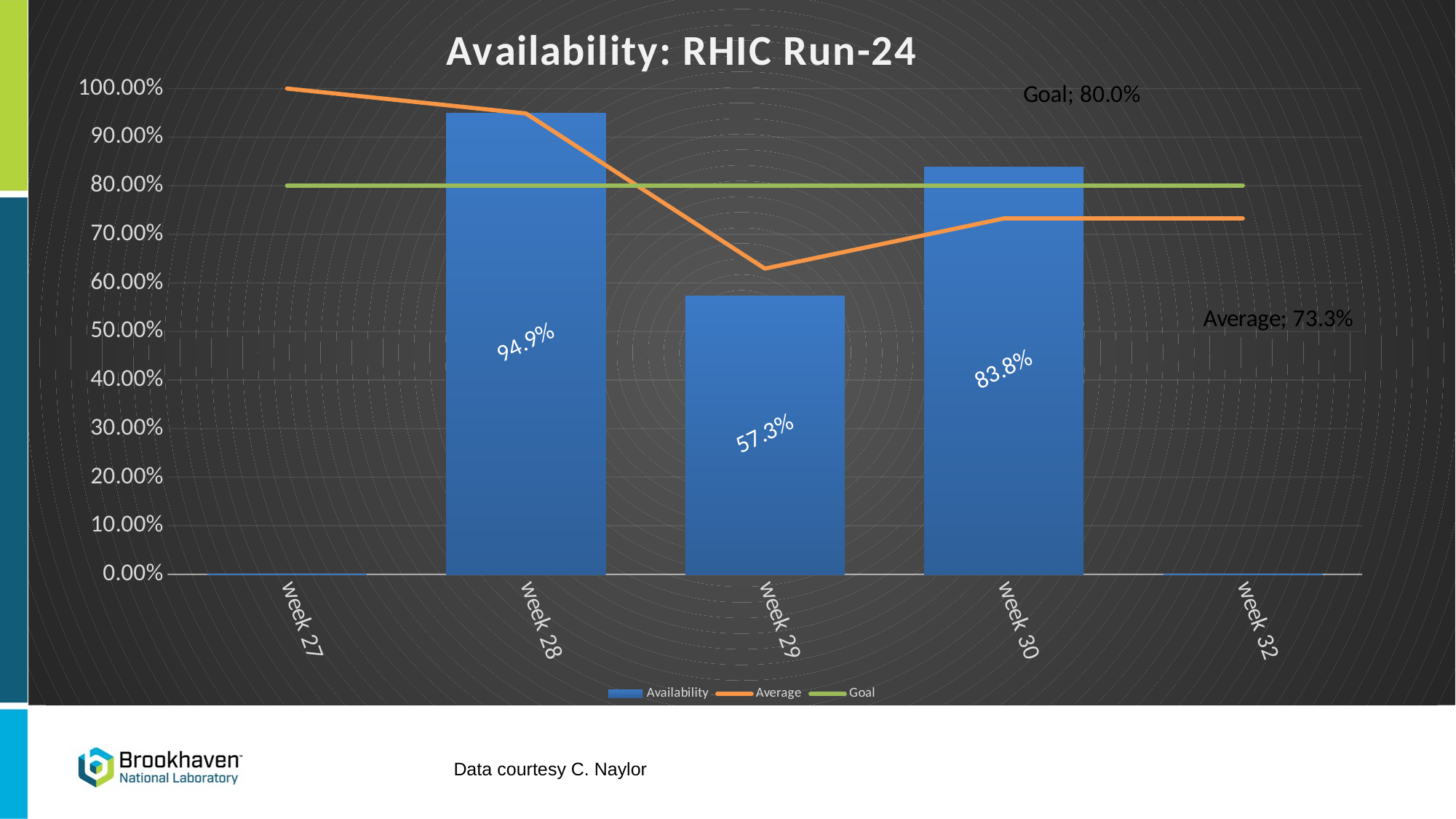
What is the Average value shown on the chart? 73.3% Is the availability for week 29 greater or less than 60.00%? less Of the three weeks with labeled bars, which has the lowest availability? week 29 What is the difference between the availability for week 28 and week 29? 37.6 percentage points What is the availability value shown for week 30? 83.8% What is the availability value shown for week 28? 94.9% What is the availability value shown for week 29? 57.3% How many series does the legend list? 3 Which has the higher availability, week 30 or week 29? week 30 How many week categories are shown on the x axis? 5 What is the Goal value shown on the chart? 80.0% Which week has the highest availability bar? week 28